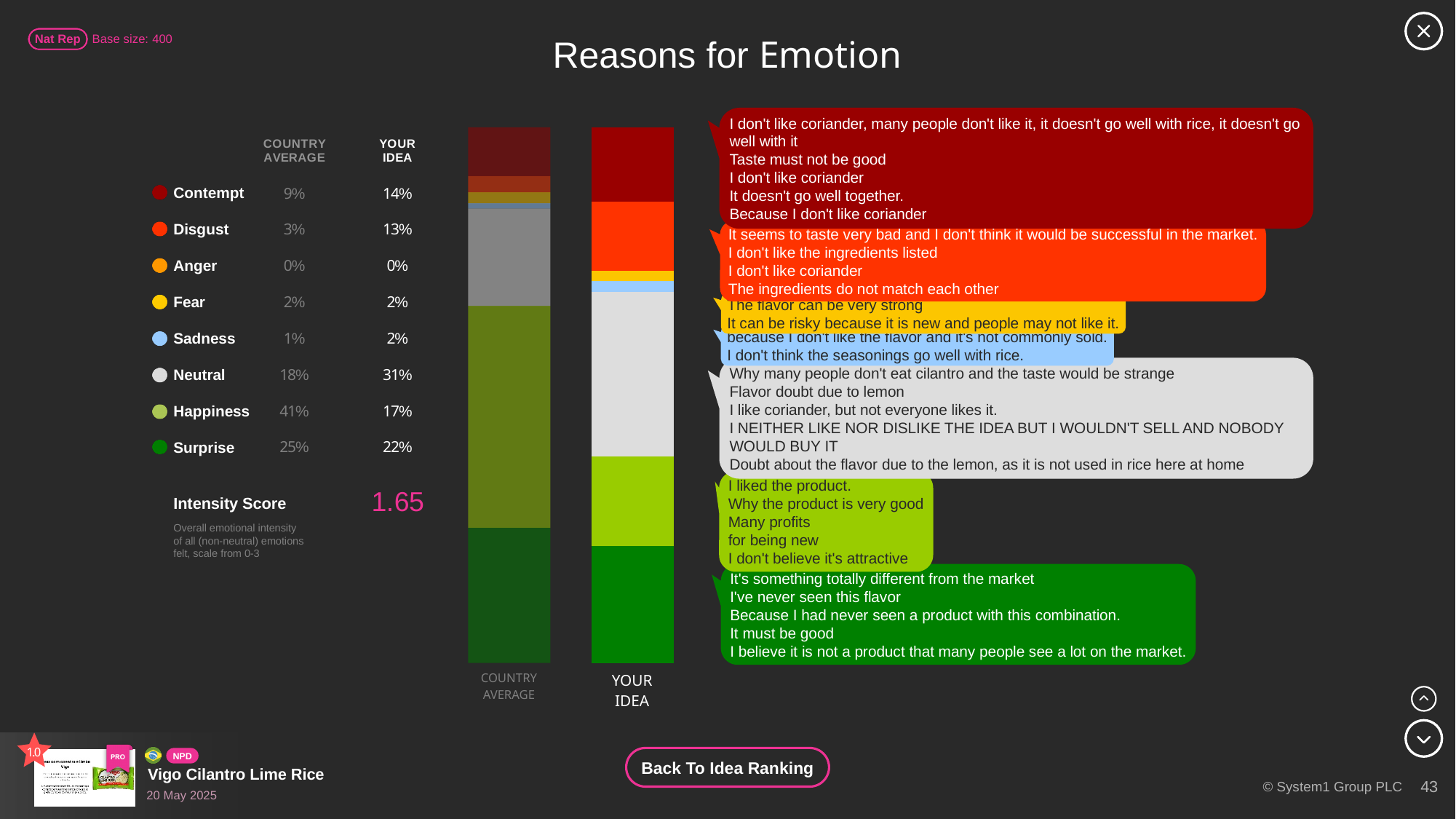
What is the Country Average value for Happiness? 41% What is the Your Idea value for Disgust? 13% How many emotion categories are shown in the chart? 8 Which emotion has the highest Your Idea value? Neutral For Happiness, which is larger: the Country Average or the Your Idea value? Country Average What is the Country Average value for Surprise? 25% What is the Your Idea value for Neutral? 31% What kind of chart is used to show the emotion breakdown? Stacked bar chart Which emotion has the lowest Your Idea value? Anger Which emotion has the highest Country Average value? Happiness What is the Intensity Score shown on the slide? 1.65 What is the difference between the Your Idea and Country Average values for Contempt? 5 percentage points